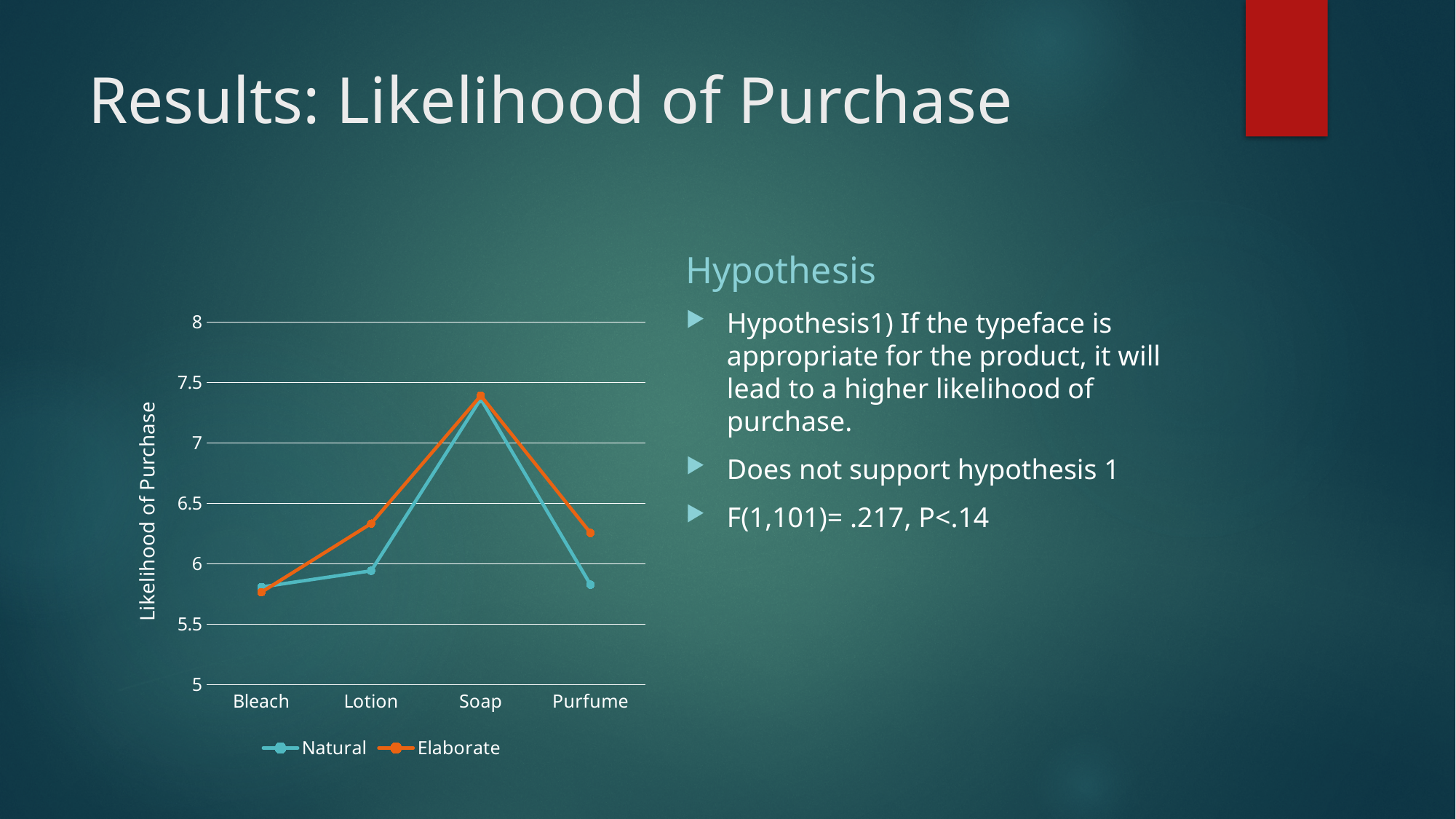
How many series does the chart's legend list? 2 For Purfume, which series has the higher value, Natural or Elaborate? Elaborate How many product categories are shown on the x axis of the chart? 4 Is the Elaborate value for Soap greater or less than 7? greater For which product is the Elaborate series highest? Soap Which series are listed in the chart's legend? Natural and Elaborate What kind of chart is shown on the slide? line chart Is the Natural value for Lotion greater or less than 6? less For which product is the Elaborate series lowest? Bleach What is the title of the chart's vertical axis? Likelihood of Purchase For which product is the Natural series highest? Soap Does the Natural series rise or fall from Soap to Purfume? fall